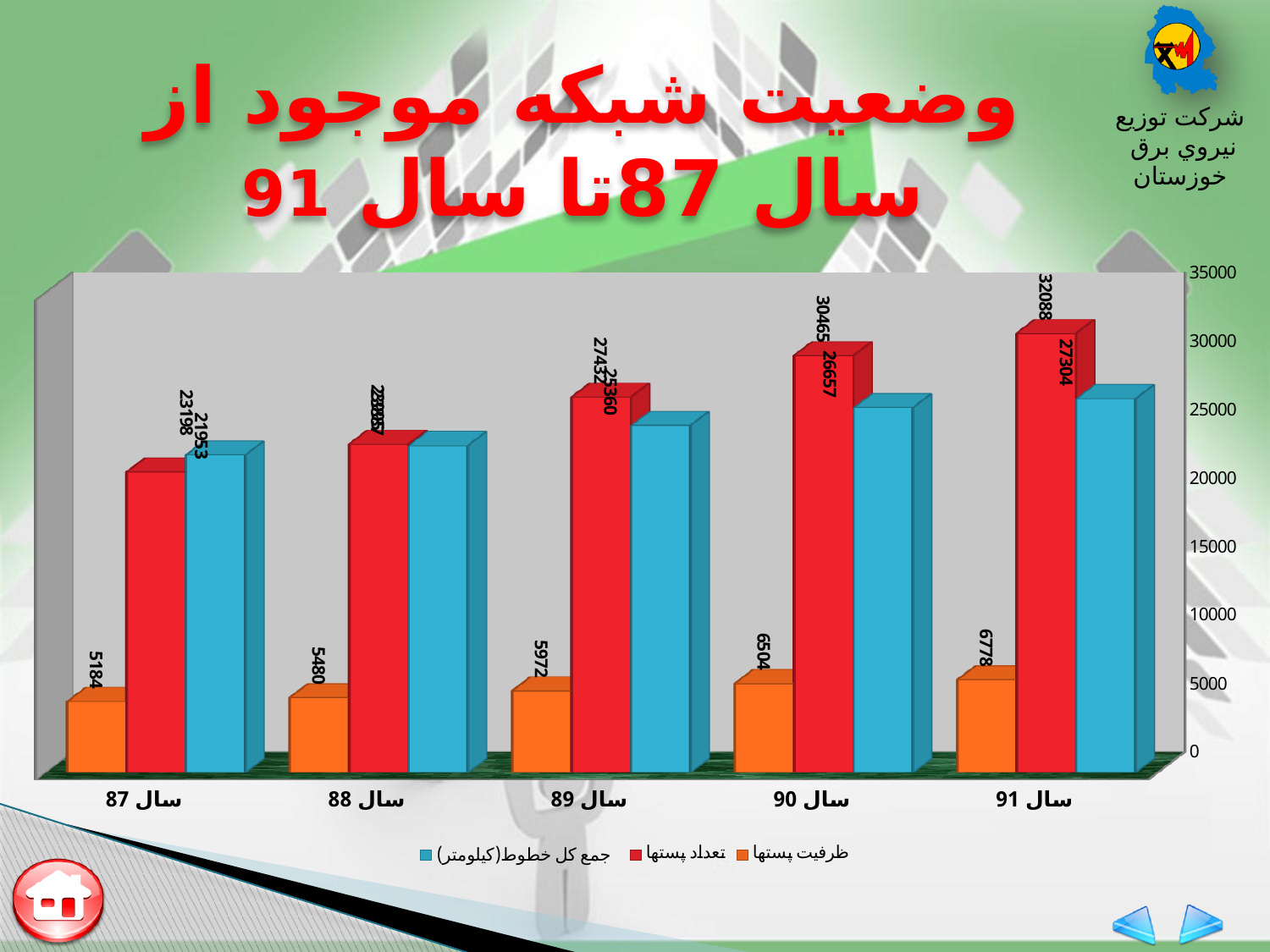
What is the value of جمع کل خطوط(کیلومتر) for سال 90? 26657 What is the difference between تعداد پستها and جمع کل خطوط(کیلومتر) for سال 90? 3808 How many series does the legend list? 3 What is the value of ظرفیت پستها for سال 89? 5972 Does the value of ظرفیت پستها rise or fall from سال 87 to سال 91? rise What is the value of ظرفیت پستها for سال 87? 5184 Which year has the highest value for ظرفیت پستها? سال 91 How many years are shown on the x axis? 5 What is the value of تعداد پستها for سال 91? 32088 What is the difference between the ظرفیت پستها values for سال 91 and سال 87? 1594 Which year has the lowest value for تعداد پستها? سال 87 Which is larger for سال 89: تعداد پستها or جمع کل خطوط(کیلومتر)? تعداد پستها